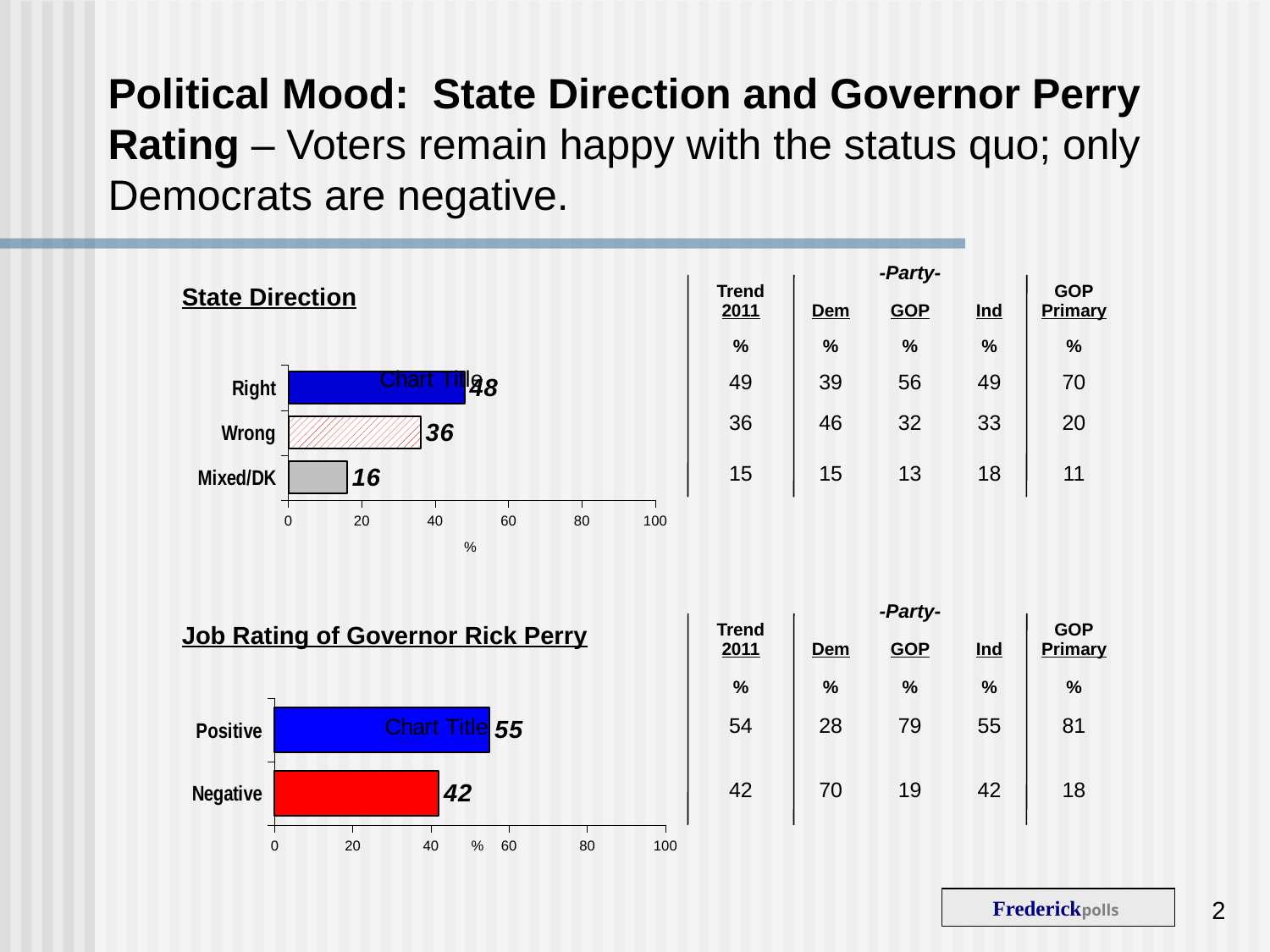
In the State Direction chart, what is the difference between the values for Right and Wrong? 12 In the State Direction chart, how many categories are plotted? 3 In the Job Rating of Governor Rick Perry chart, which is larger, Positive or Negative? Positive In the State Direction chart, what is the value for Mixed/DK? 16 In the Job Rating of Governor Rick Perry chart, what is the value for Negative? 42 In the Job Rating of Governor Rick Perry chart, what is the difference between Positive and Negative? 13 In the State Direction chart, which category has the lowest value? Mixed/DK In the State Direction chart, what is the value for Right? 48 In the State Direction chart, is the value for Wrong greater or less than 40? less In the Job Rating of Governor Rick Perry chart, what is the value for Positive? 55 What kind of chart is the Job Rating of Governor Rick Perry chart? Bar chart In the State Direction chart, which category has the highest value? Right